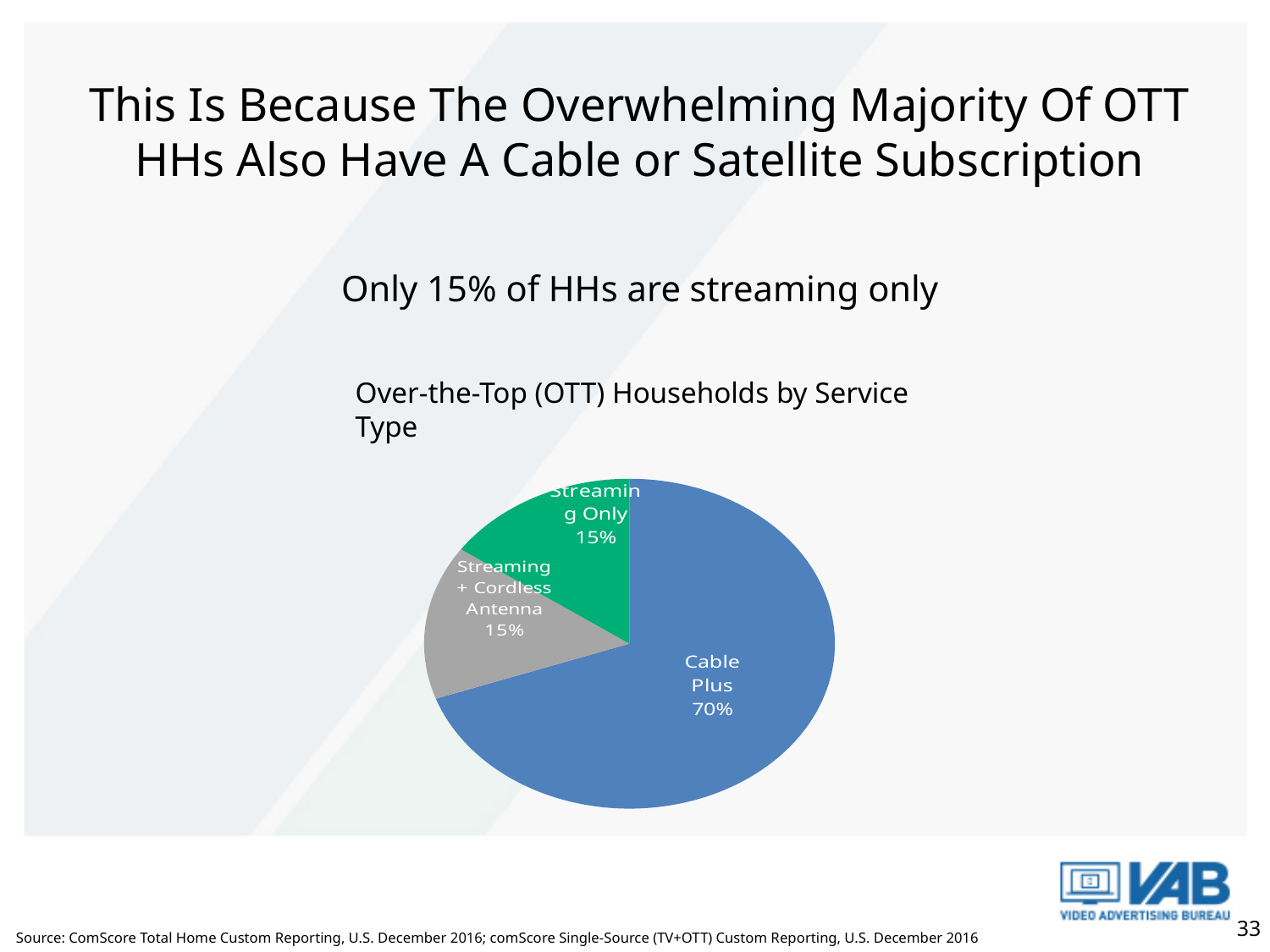
What is the combined share of Streaming Only and Streaming + Cordless Antenna? 30% What type of chart is shown on the slide? pie chart Which service type has the largest share of the pie? Cable Plus What share of OTT households is Streaming Only? 15% Which is larger, the Cable Plus share or the Streaming + Cordless Antenna share? Cable Plus What is the difference in percentage points between Cable Plus and Streaming Only? 55 What share of OTT households is Cable Plus? 70% What colour is the Cable Plus slice? blue How many slices does the pie chart have? 3 What is the title of the chart? Over-the-Top (OTT) Households by Service Type What share of OTT households is Streaming + Cordless Antenna? 15%